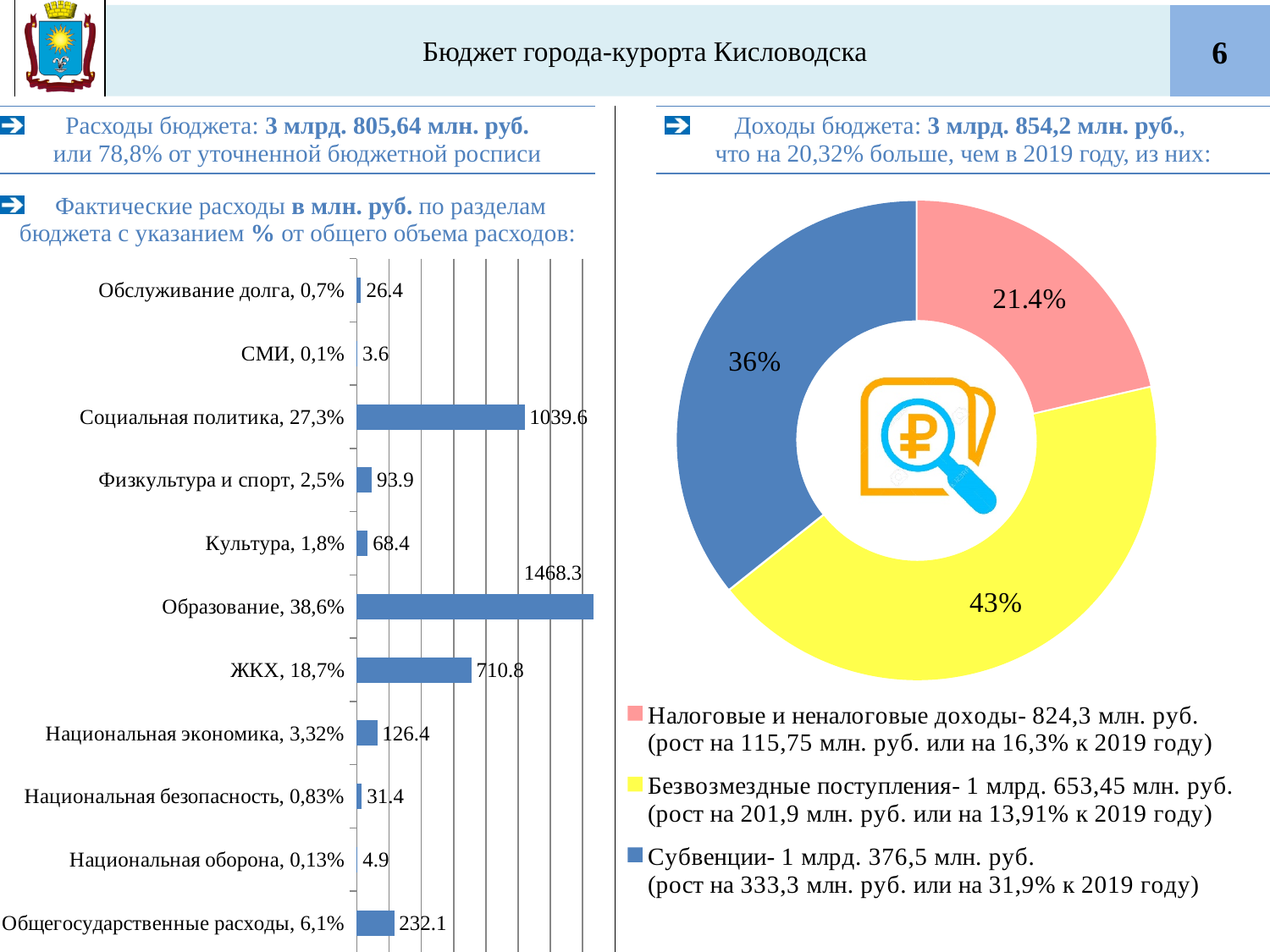
On the left bar chart, which category has the lowest value? СМИ On the left bar chart, what is the value for ЖКХ? 710.8 What type of chart is shown on the left side of the slide? Bar chart On the right doughnut chart, what share is shown for Налоговые и неналоговые доходы? 21.4% How many categories are shown on the left bar chart? 11 On the right doughnut chart, which slice is the largest? Безвозмездные поступления On the left bar chart, which category has the highest value? Образование How many slices does the right doughnut chart have? 3 On the left bar chart, which is larger: the value for Национальная экономика or the value for Физкультура и спорт? Национальная экономика On the right doughnut chart, what share is shown for the yellow slice (Безвозмездные поступления)? 43% On the left bar chart, what is the value for Образование? 1468.3 On the left bar chart, what is the difference between the values for Социальная политика and ЖКХ? 328.8